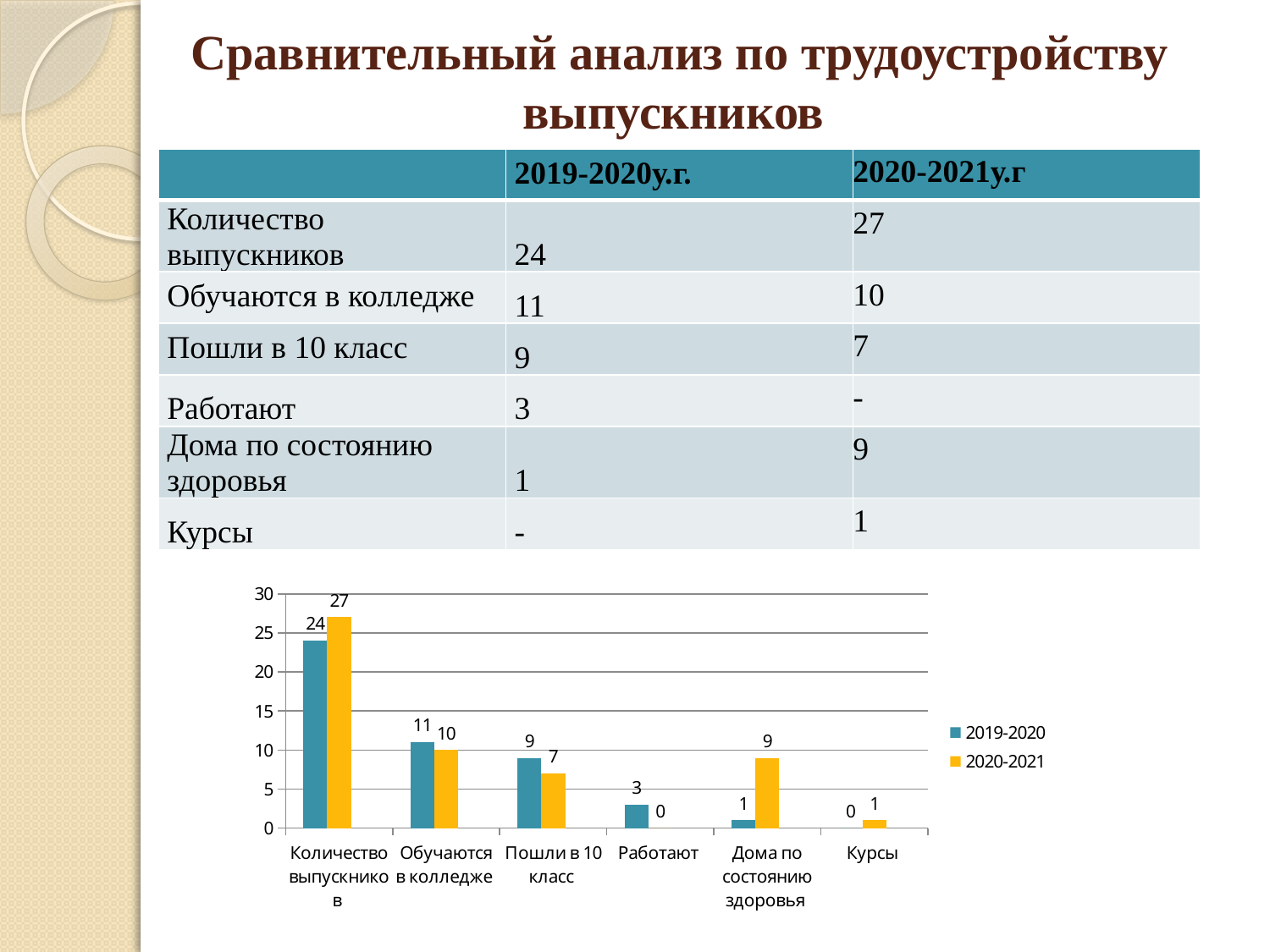
Is the 2020-2021 value for 'Количество выпускников' greater or less than 25? greater What is the value for 2020-2021 in the 'Дома по состоянию здоровья' category? 9 Which is larger for 'Пошли в 10 класс': the 2019-2020 value or the 2020-2021 value? 2019-2020 What kind of chart is shown on the slide? bar chart How many categories are shown on the x axis of the chart? 6 Which category has the highest value for the 2019-2020 series? Количество выпускников What is the difference between the 2020-2021 and 2019-2020 values for 'Количество выпускников'? 3 Which category has the lowest value for the 2020-2021 series? Работают What is the value for 2020-2021 in the 'Количество выпускников' category? 27 How many series does the chart legend list? 2 What colour are the bars for the 2020-2021 series? yellow What is the value for 2019-2020 in the 'Обучаются в колледже' category? 11